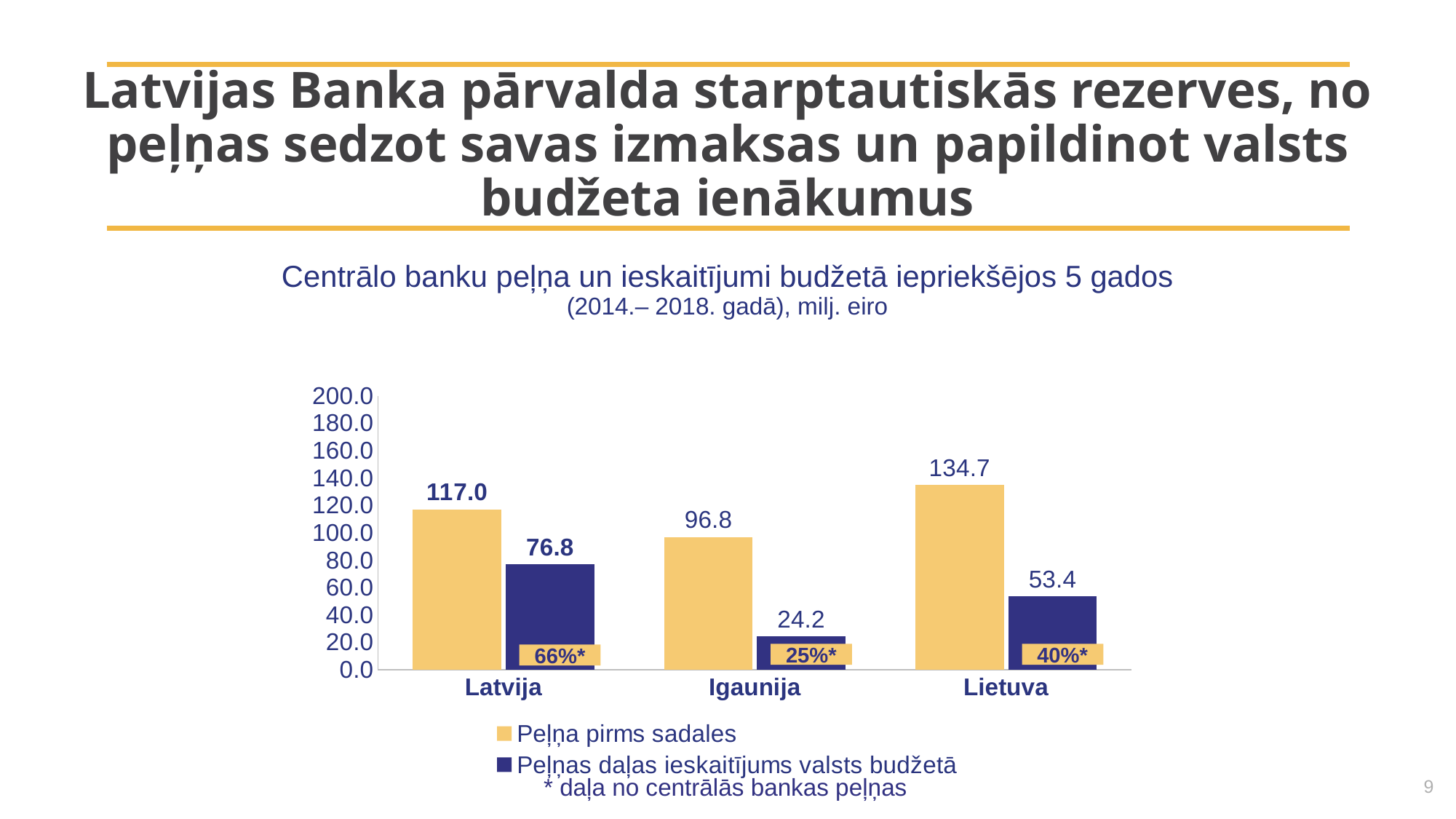
How many series does the legend list? 2 What is the difference between "Peļņa pirms sadales" and "Peļņas daļas ieskaitījums valsts budžetā" for Latvija? 40.2 What is the value of "Peļņas daļas ieskaitījums valsts budžetā" for Igaunija? 24.2 What kind of chart is shown on the slide? bar chart Which country has the lowest value for "Peļņas daļas ieskaitījums valsts budžetā"? Igaunija What is the value of "Peļņa pirms sadales" for Lietuva? 134.7 How many countries are shown on the x axis? 3 What is the value of "Peļņa pirms sadales" for Latvija? 117.0 What percentage label is shown for Lietuva? 40%* Which country has the highest value for "Peļņa pirms sadales"? Lietuva Is the value of "Peļņa pirms sadales" for Igaunija greater or less than 100.0? less Which is larger: "Peļņas daļas ieskaitījums valsts budžetā" for Latvija or for Lietuva? Latvija